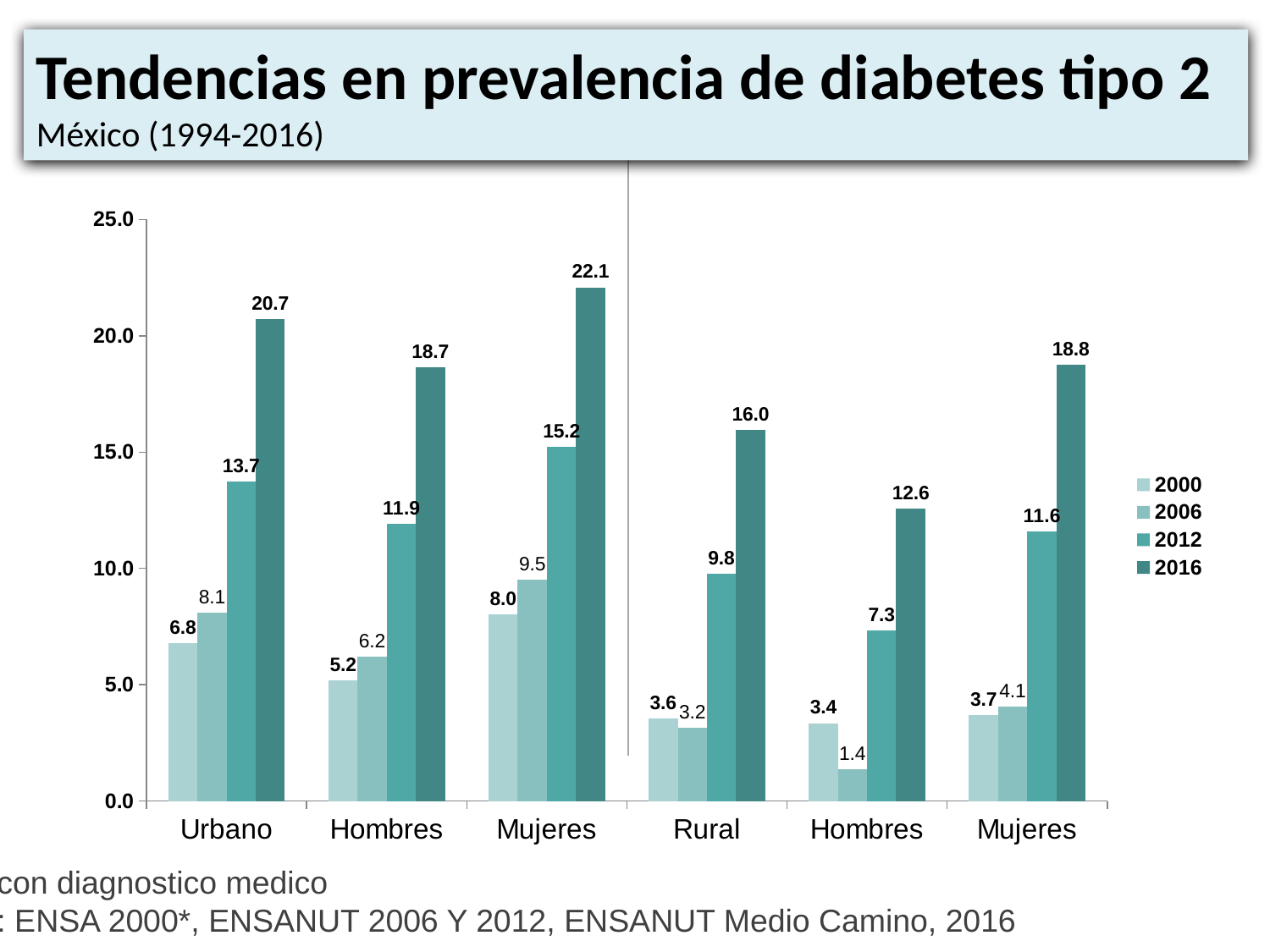
What is the difference between the 2016 and 2000 values for Urbano? 13.9 Is the 2016 value for Rural greater or less than 15.0? greater What is the value for Urbano in the 2016 series? 20.7 How many categories are shown on the x axis? 6 What kind of chart is shown on the slide? Bar chart Which is larger in the 2012 series: Urbano or Mujeres in the Rural group? Urbano How many series does the legend list? 4 Which category has the highest value in the 2016 series? Mujeres (Urbano group) What is the value for Rural in the 2012 series? 9.8 What is the lowest value shown on the chart? 1.4 What is the 2006 value for Hombres in the Rural group (the fifth category)? 1.4 Do the values for Urbano rise or fall from 2000 to 2016? Rise